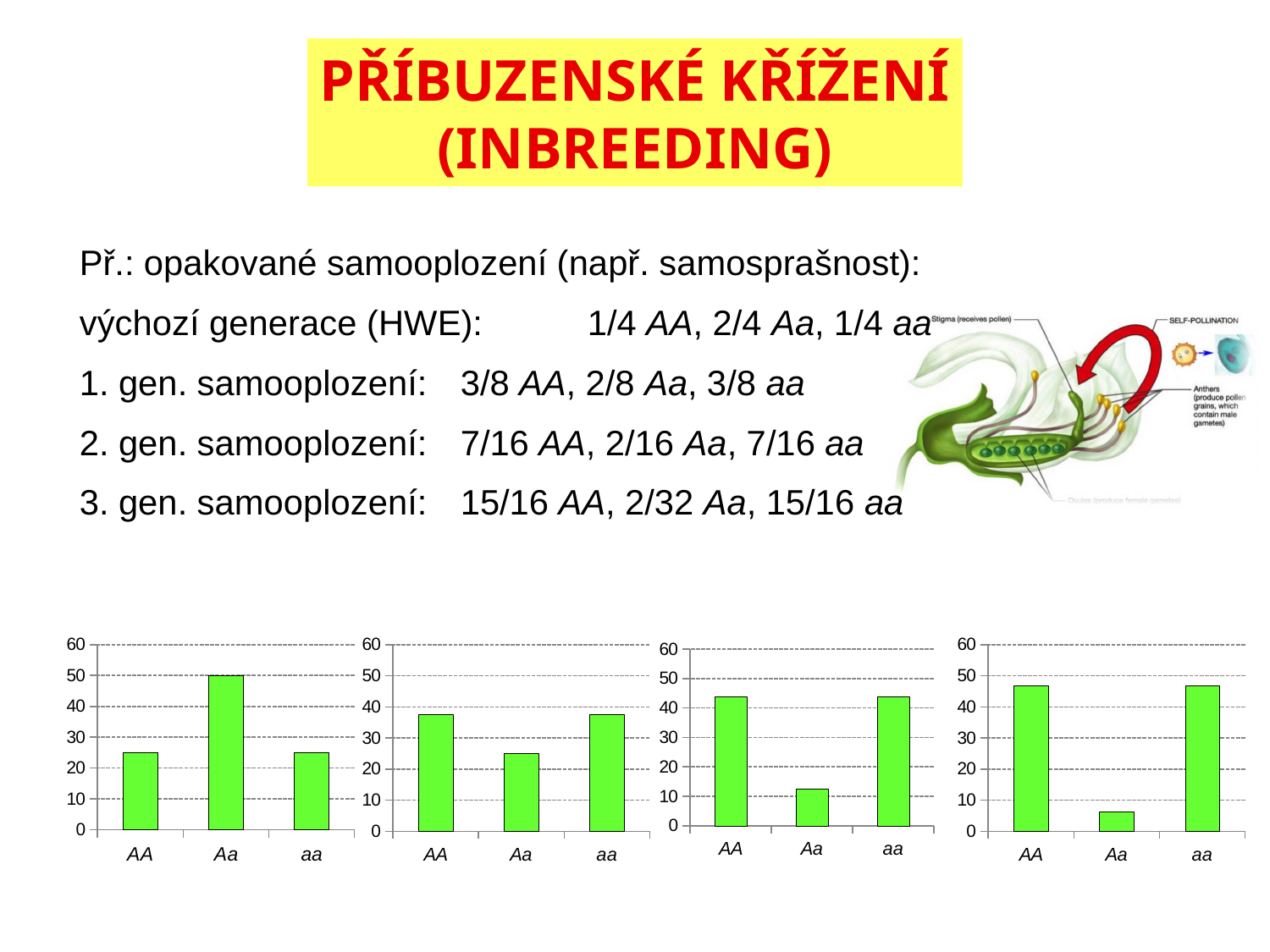
How many categories are shown on the x axis of the leftmost chart? 3 In the rightmost chart, is the value for Aa greater or less than 10? less In the leftmost chart, which category has the highest bar? Aa How many bar charts are shown on the slide? 4 In the rightmost chart, which is larger, the value for AA or the value for Aa? AA In the second chart from the left, is the value for AA greater or less than 30? greater In the third chart from the left, is the value for Aa greater or less than 20? less What colour are the bars in the charts on the slide? green What kind of chart is the rightmost chart? bar chart In the second chart from the left, which category has the lowest bar? Aa In the leftmost chart, what is the value for Aa? 50